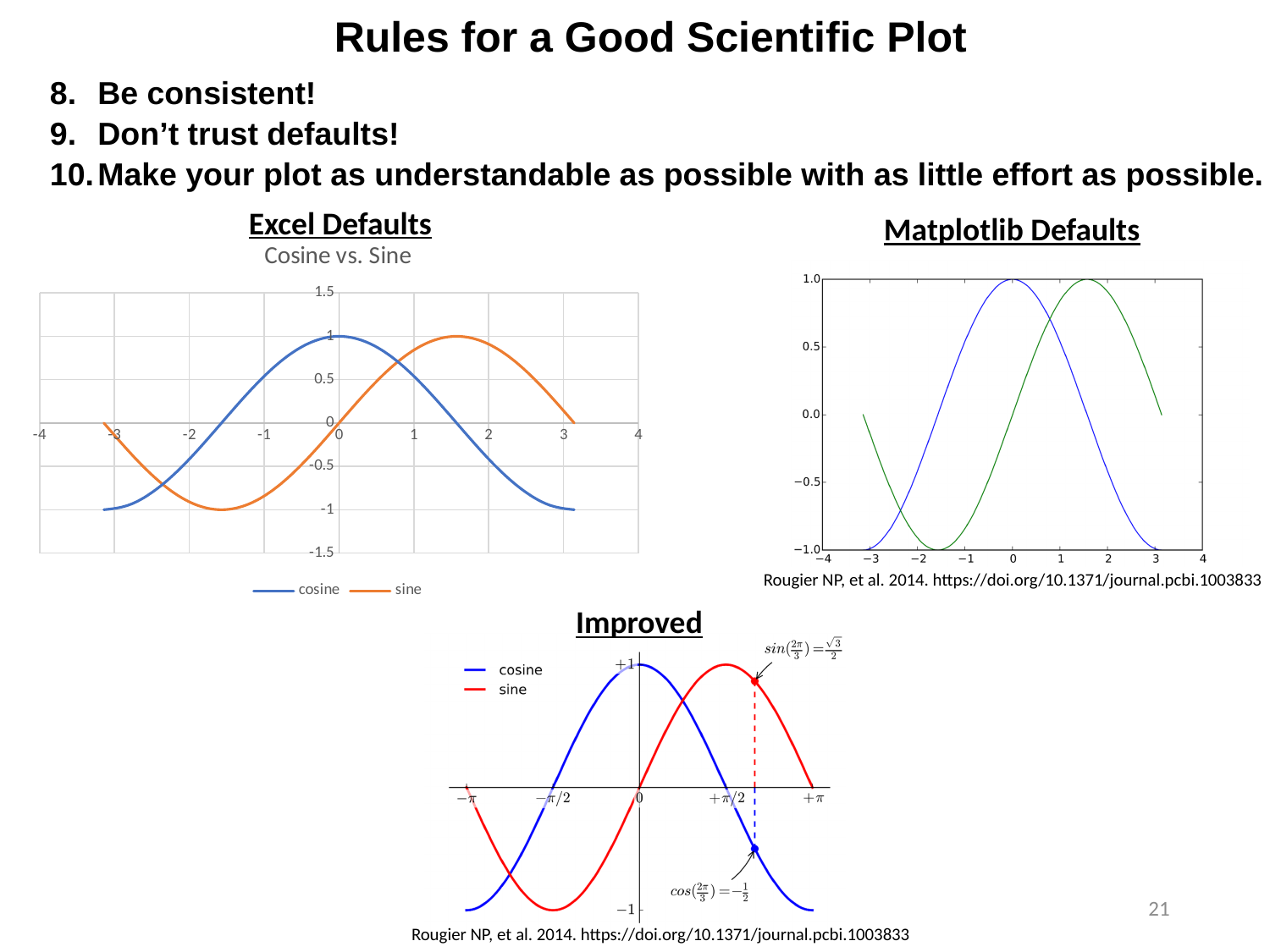
In the Excel Defaults chart, at x = 0, which series has the larger value, cosine or sine? cosine In the Improved chart, what value is annotated for cos(2π/3)? -1/2 In the Excel Defaults chart, what is the value of the cosine series at x = 0? 1 In the Excel Defaults chart, what kind of chart is shown? line chart What is the title of the Excel Defaults chart? Cosine vs. Sine In the Excel Defaults chart, is the value of the sine series at x = 1 greater or less than 0.5? greater In the Improved chart, what colour is the sine line? red In the Excel Defaults chart, does the sine series rise or fall between x = 0 and x = 1? rise In the Excel Defaults chart, how many series does the legend list? 2 In the Matplotlib Defaults chart, how many lines are plotted? 2 In the Improved chart, how many series does the legend list? 2 In the Matplotlib Defaults chart, is the value of the blue line at x = 0 greater or less than 0.5? greater